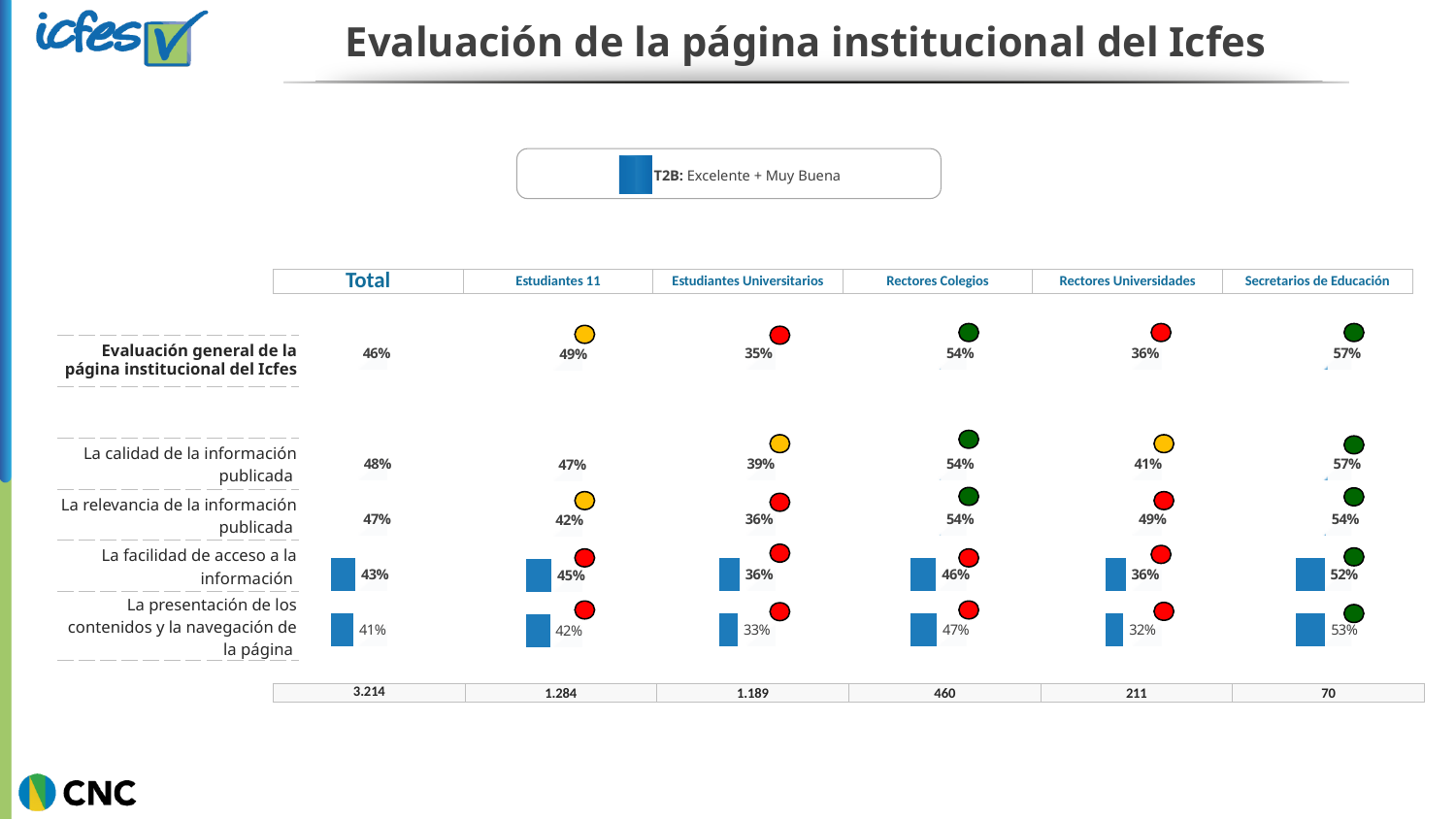
What is the value for 'La facilidad de acceso a la información' among Estudiantes Universitarios? 36% What is the value for 'La presentación de los contenidos y la navegación de la página' among Rectores Universidades? 32% For 'La relevancia de la información publicada', which is larger: Estudiantes 11 or Rectores Universidades? Rectores Universidades What is the difference between the Rectores Colegios and Estudiantes Universitarios values for 'La calidad de la información publicada'? 15 percentage points What is the value for 'La calidad de la información publicada' among Secretarios de Educación? 57% What is the Total value for 'Evaluación general de la página institucional del Icfes'? 46% How many respondent groups are shown in the column headers, including Total? 6 What is the base size shown for the Total column? 3.214 Which group has the lowest value for 'La presentación de los contenidos y la navegación de la página'? Rectores Universidades Which group has the highest value for 'Evaluación general de la página institucional del Icfes'? Secretarios de Educación What does the legend say T2B stands for? Excelente + Muy Buena How many attributes (rows) are evaluated on the slide? 5